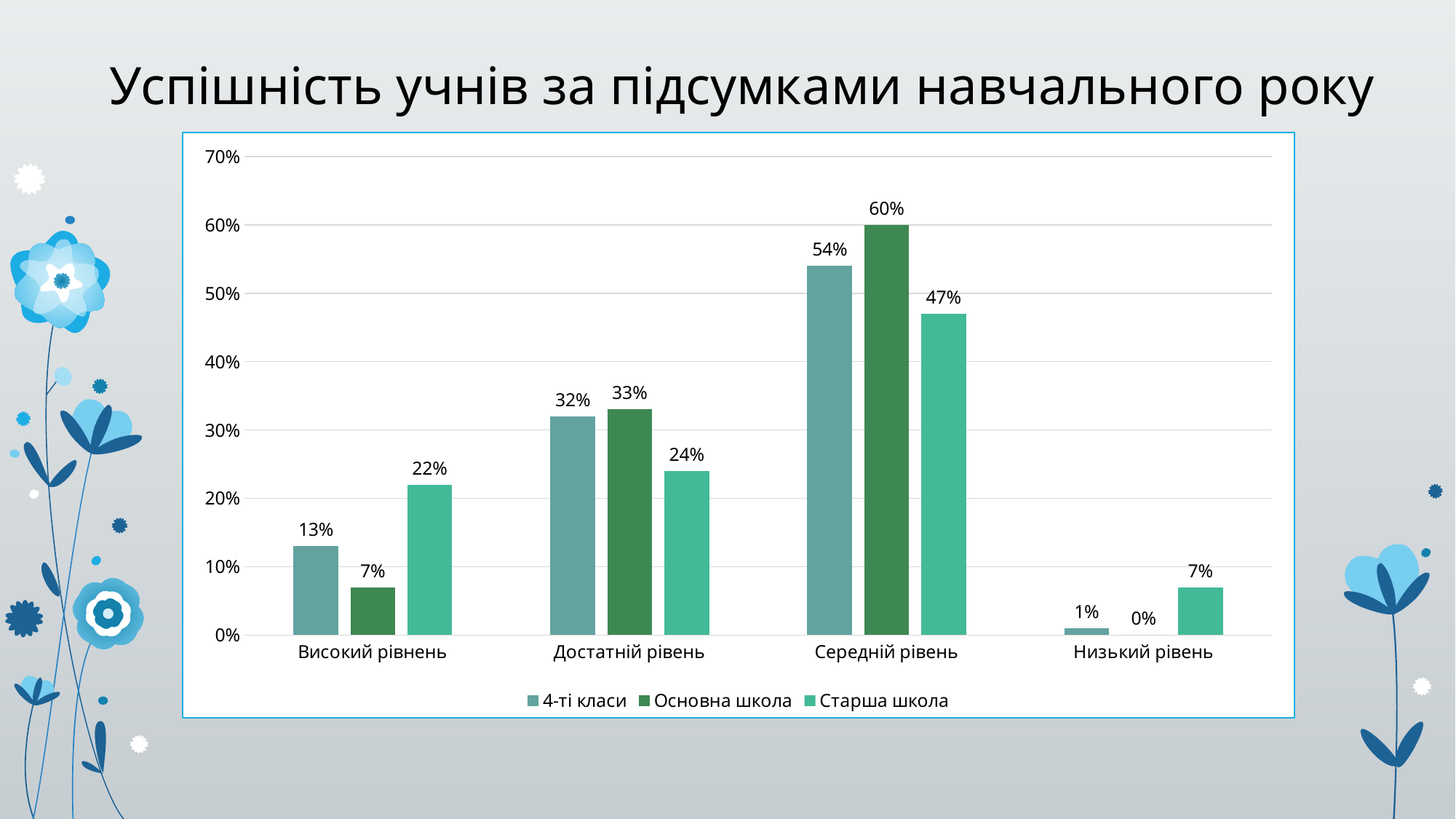
What is the value for Старша школа in the Високий рівень category? 22% What is the value for Основна школа in the Середній рівень category? 60% What is the title of the slide? Успішність учнів за підсумками навчального року What is the difference between the Основна школа and Старша школа values in the Середній рівень category? 13% What is the value for Старша школа in the Достатній рівень category? 24% Which category has the lowest value for Основна школа? Низький рівень How many series does the legend list? 3 Which is larger in the Високий рівень category: the value for 4-ті класи or for Основна школа? 4-ті класи Which category has the highest value for 4-ті класи? Середній рівень How many categories are shown on the x axis? 4 What kind of chart is shown on the slide? Bar chart What is the value for 4-ті класи in the Низький рівень category? 1%